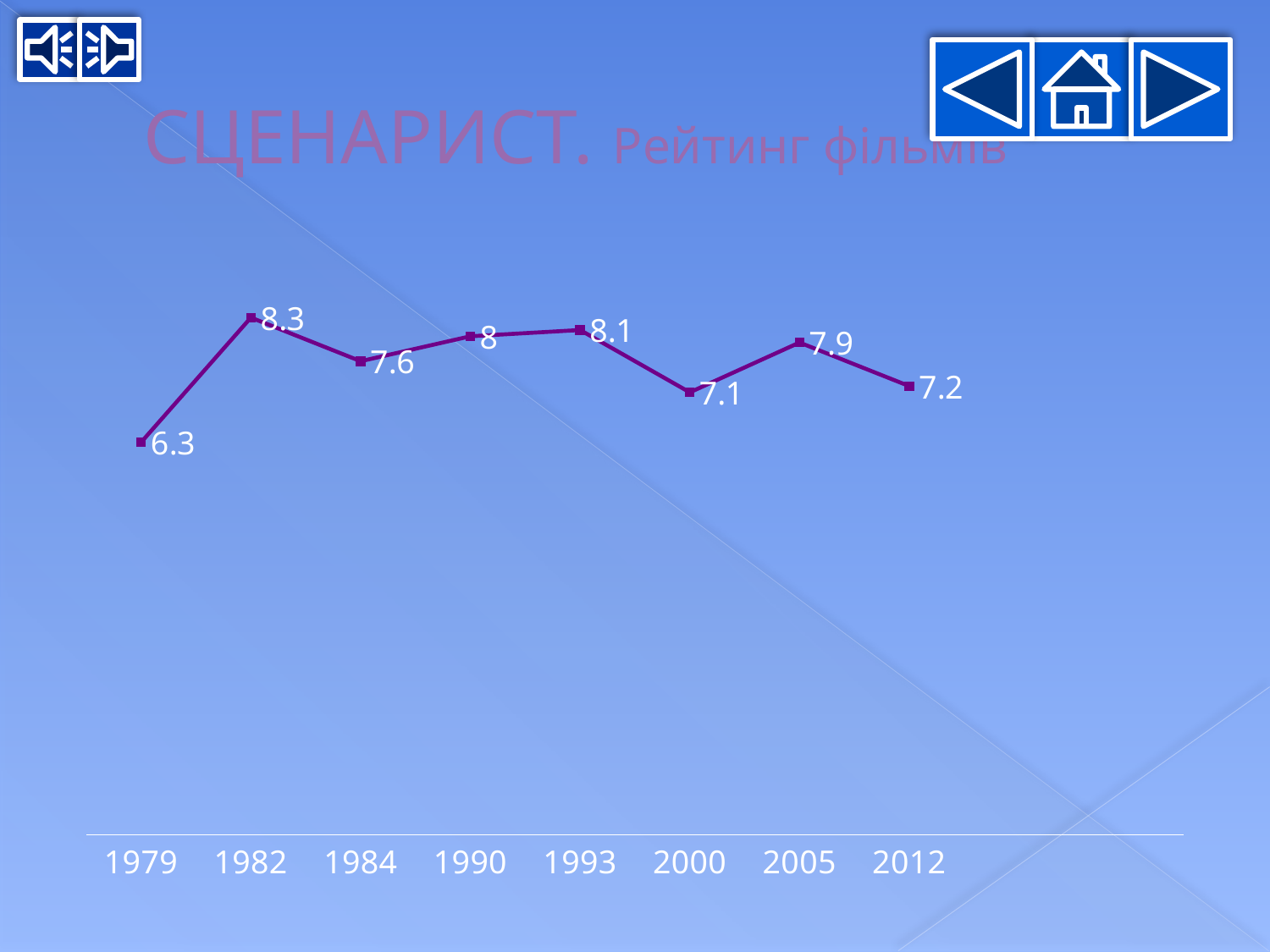
What is the rating value for 2012? 7.2 Which year has a higher rating, 1984 or 1990? 1990 What is the rating value for 1979? 6.3 What is the rating value for 2000? 7.1 Which year has the highest rating? 1982 Which year has the lowest rating? 1979 What is the difference between the ratings for 2005 and 2000? 0.8 What is the difference between the ratings for 1982 and 1979? 2 Does the rating rise or fall from 1993 to 2000? fall What is the rating value for 1982? 8.3 How many years are plotted on the chart? 8 What kind of chart is shown on the slide? line chart